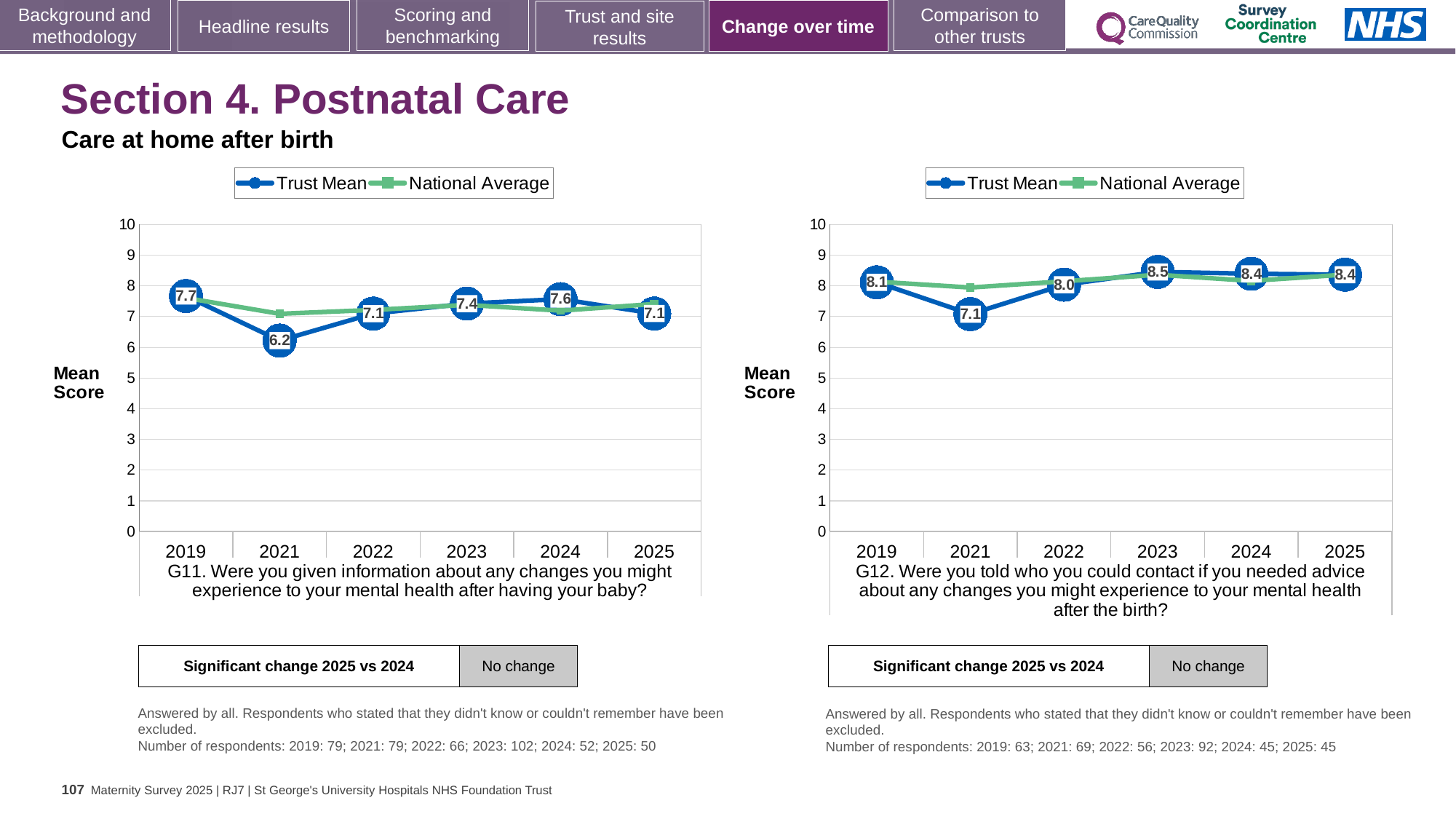
On the G11 chart (left), what is the Trust Mean score for 2021? 6.2 How many series does the legend of the G12 chart (right) list? 2 On the G11 chart (left), which year has the lowest Trust Mean score? 2021 On the G11 chart (left), what is the difference between the Trust Mean scores for 2019 and 2021? 1.5 On the G12 chart (right), what is the Trust Mean score for 2021? 7.1 On the G12 chart (right), is the National Average for 2021 greater or less than 7? greater On the G12 chart (right), what is the Trust Mean score for 2023? 8.5 On the G11 chart (left), what is the Trust Mean score for 2024? 7.6 On the G11 chart (left), which year has the highest Trust Mean score? 2019 How many years are plotted on the x axis of the G11 chart (left)? 6 On the G12 chart (right), which year has the lowest Trust Mean score? 2021 On the G12 chart (right), is the Trust Mean score for 2019 or 2022 larger? 2019